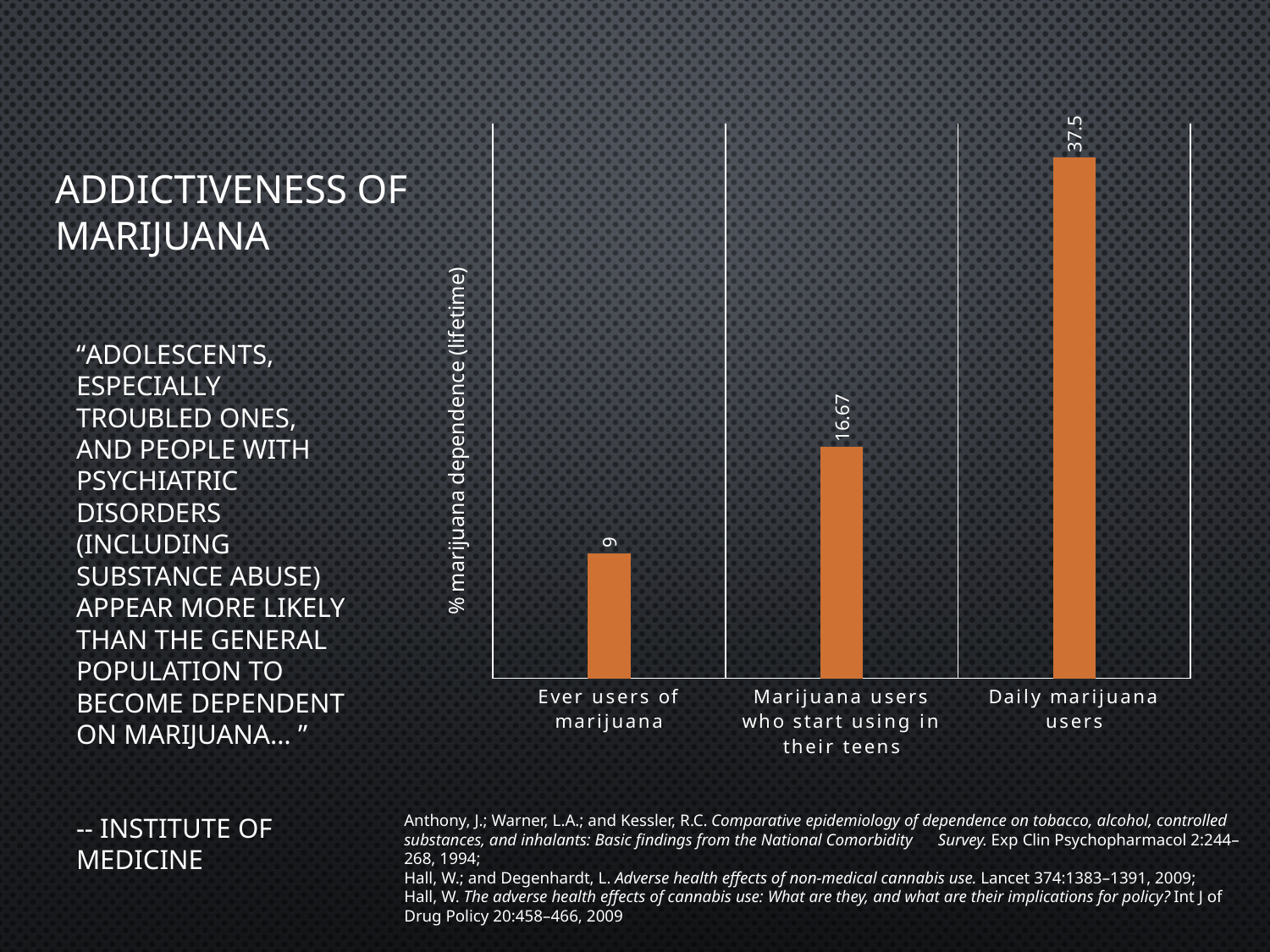
What is the value for Ever users of marijuana? 9 Which category has the highest value? Daily marijuana users How many categories are shown in the chart? 3 What is the value for Daily marijuana users? 37.5 What is the difference between the values for Marijuana users who start using in their teens and Ever users of marijuana? 7.67 What is the label of the vertical axis? % marijuana dependence (lifetime) What kind of chart is shown on the slide? Bar chart Which is larger: the value for Daily marijuana users or the value for Marijuana users who start using in their teens? Daily marijuana users What is the difference between the values for Daily marijuana users and Ever users of marijuana? 28.5 Do the values rise or fall from left to right across the categories? Rise What is the value for Marijuana users who start using in their teens? 16.67 Which category has the lowest value? Ever users of marijuana